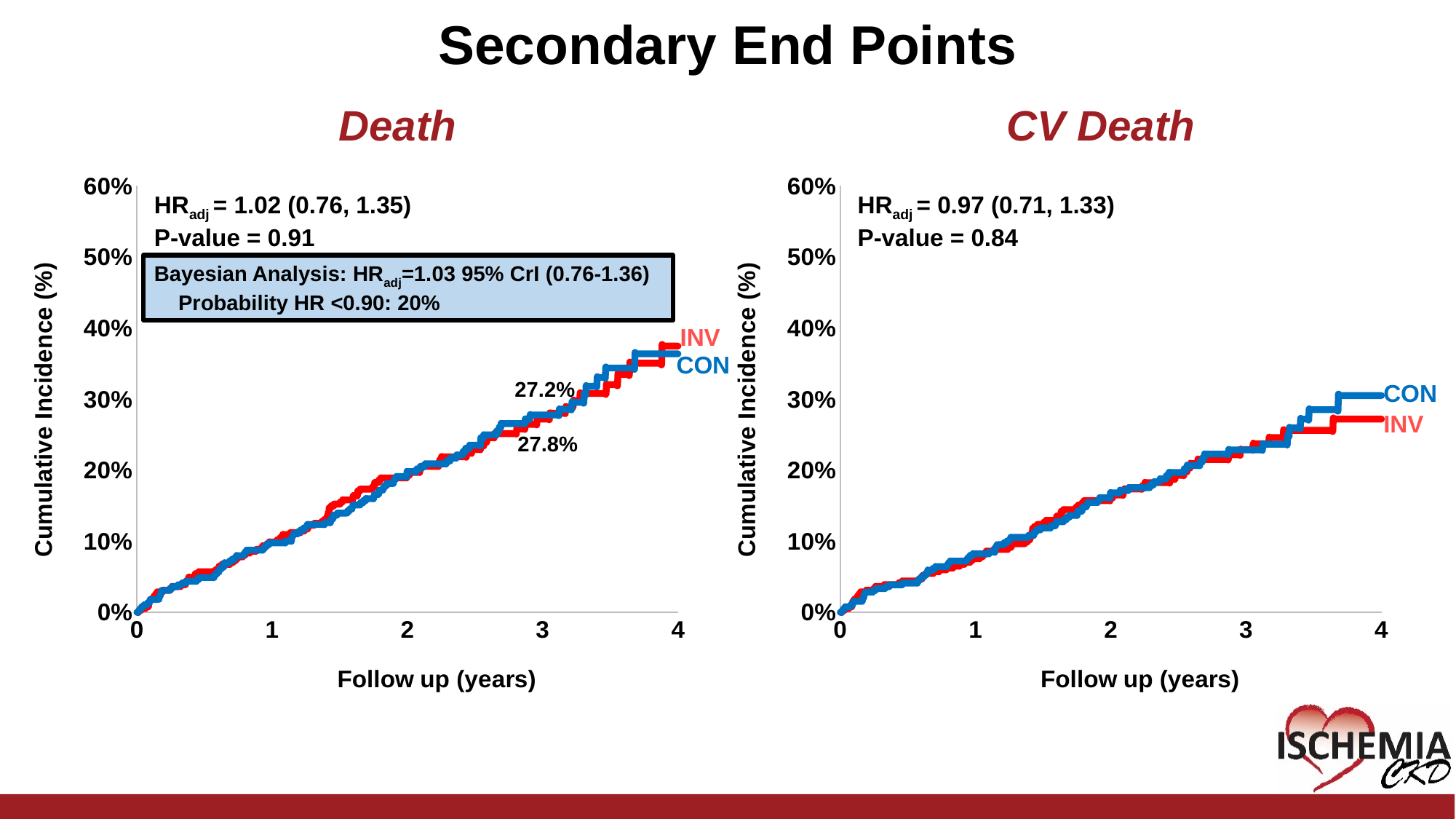
On the Death chart, is the value for CON at year 1 greater or less than 20%? less On the CV Death chart, is the value for CON at year 4 greater or less than 20%? greater How many series are plotted on the CV Death chart? 2 On the Death chart, what is the adjusted hazard ratio with its confidence interval? 1.02 (0.76, 1.35) What is the maximum follow-up value shown on the x axis of the CV Death chart? 4 On the CV Death chart, is the value for INV at year 4 greater or less than 30%? less What kind of chart is the Death chart? line chart On the Death chart, what are the two data labels printed near year 3? 27.2% and 27.8% On the Death chart, do the cumulative incidence values rise or fall as follow-up years increase? rise On the Death chart, what is the Bayesian probability that HR is less than 0.90? 20% On the CV Death chart, which series has the higher value at year 4, CON or INV? CON